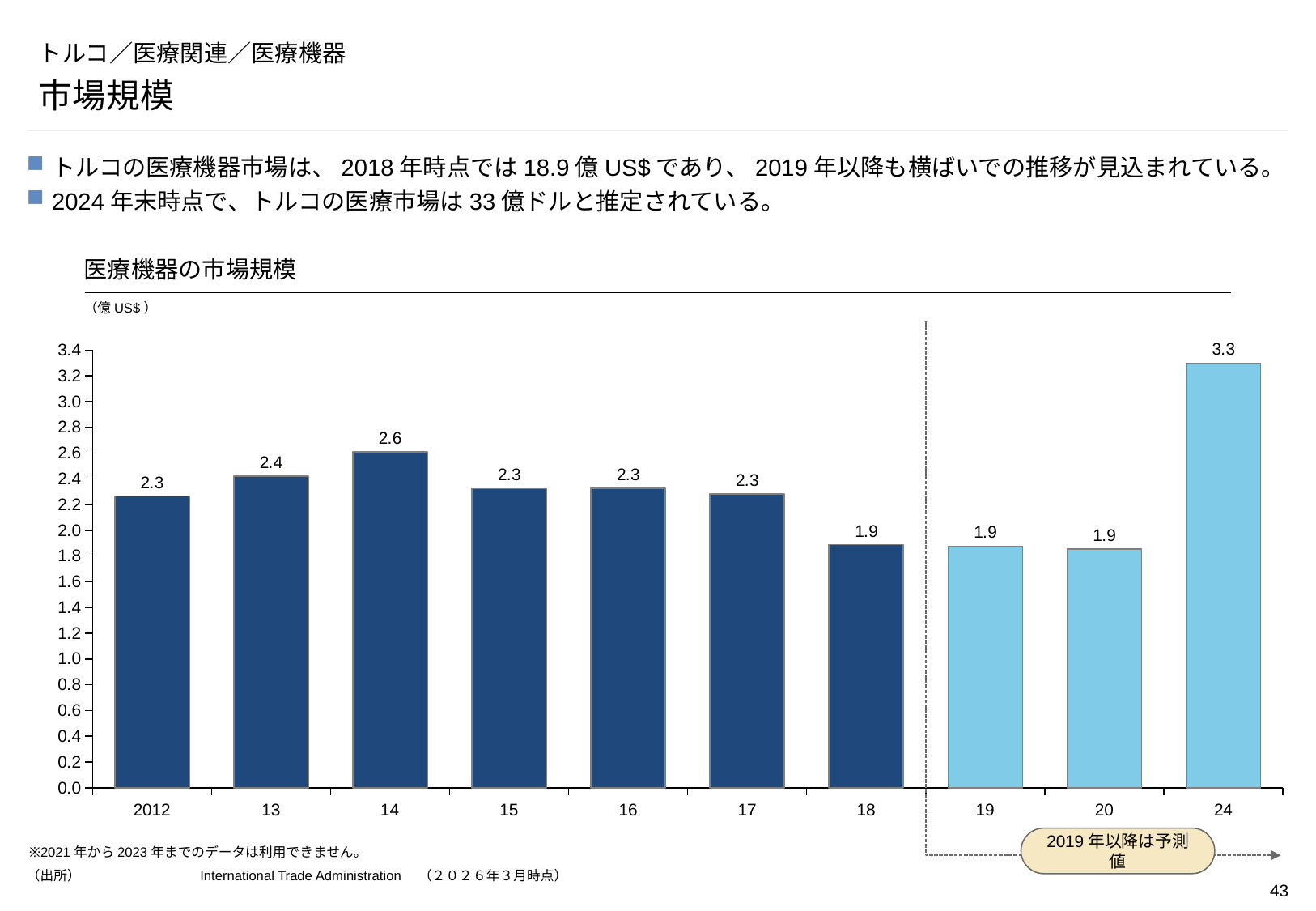
What is the difference between the values for 14 and 13? 0.2 What is the difference between the values for 24 and 18? 1.4 Which is larger, the value for 14 or the value for 13? 14 What is the value for 2012 in the chart? 2.3 Which year has the highest value in the chart? 24 How many bars are plotted in the chart? 10 Is the value for 2012 greater or less than 2.0? greater What unit is shown for the values in the chart? 億US$ What is the value for 2018 in the 医療機器の市場規模 chart? 1.9 What is the value for 14 (2014) in the chart? 2.6 What is the value for 24 (2024) in the chart? 3.3 What kind of chart is shown on the slide? bar chart